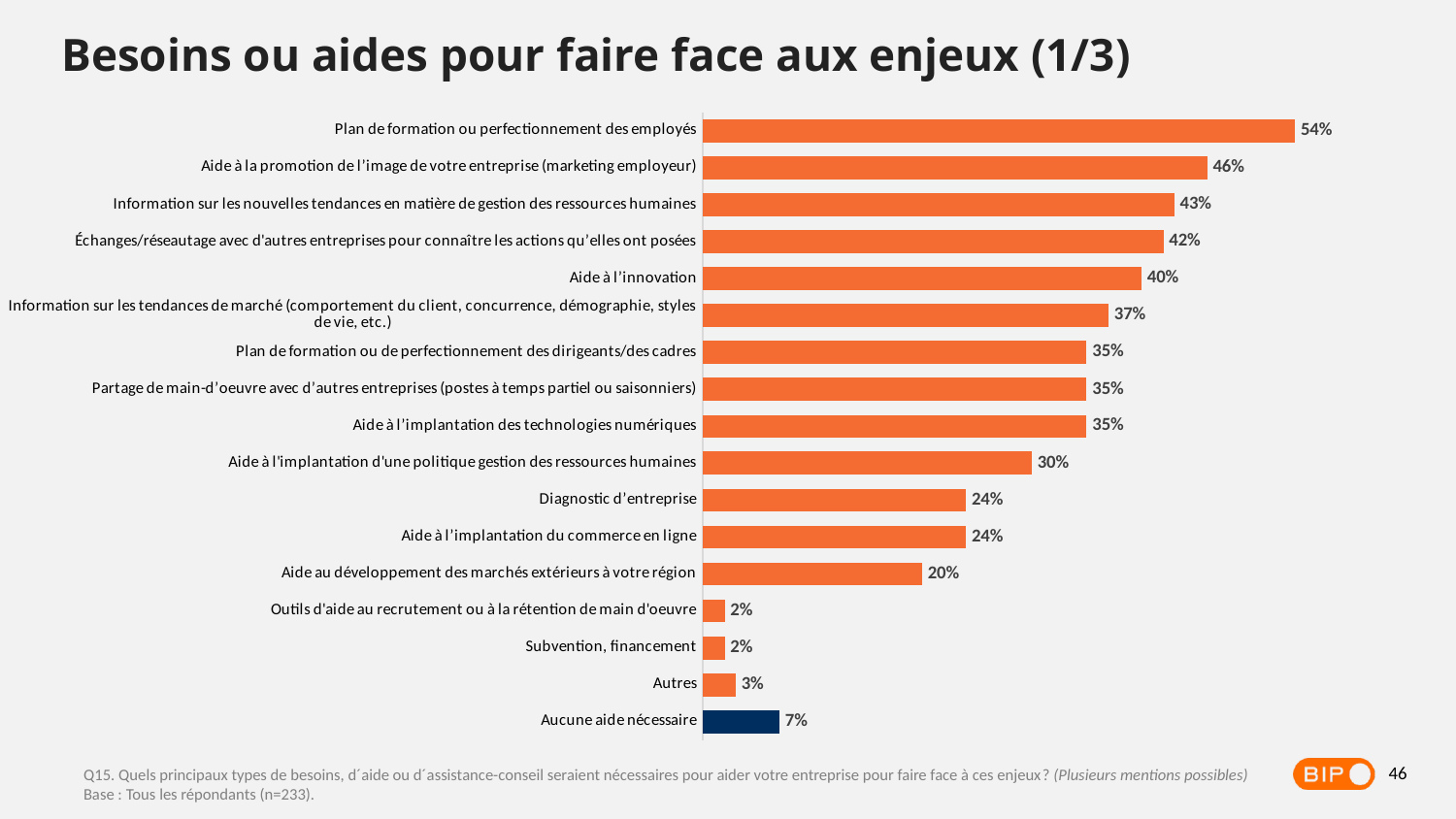
What is the lowest value shown in the chart? 2% What is the value for "Plan de formation ou perfectionnement des employés"? 54% What is the value for "Aide à l'innovation"? 40% Which category has the highest value? Plan de formation ou perfectionnement des employés What type of chart is shown on the slide? bar chart What is the value for "Aucune aide nécessaire"? 7% How many categories are shown in the chart? 17 Which is larger: "Diagnostic d'entreprise" or "Aide à l'implantation d'une politique gestion des ressources humaines"? Aide à l'implantation d'une politique gestion des ressources humaines What is the difference between "Plan de formation ou perfectionnement des employés" and "Aide à la promotion de l'image de votre entreprise (marketing employeur)"? 8% What is the difference between "Autres" and "Subvention, financement"? 1% Which category's bar is shown in a different colour (dark blue) from the others? Aucune aide nécessaire What is the value for "Aide au développement des marchés extérieurs à votre région"? 20%